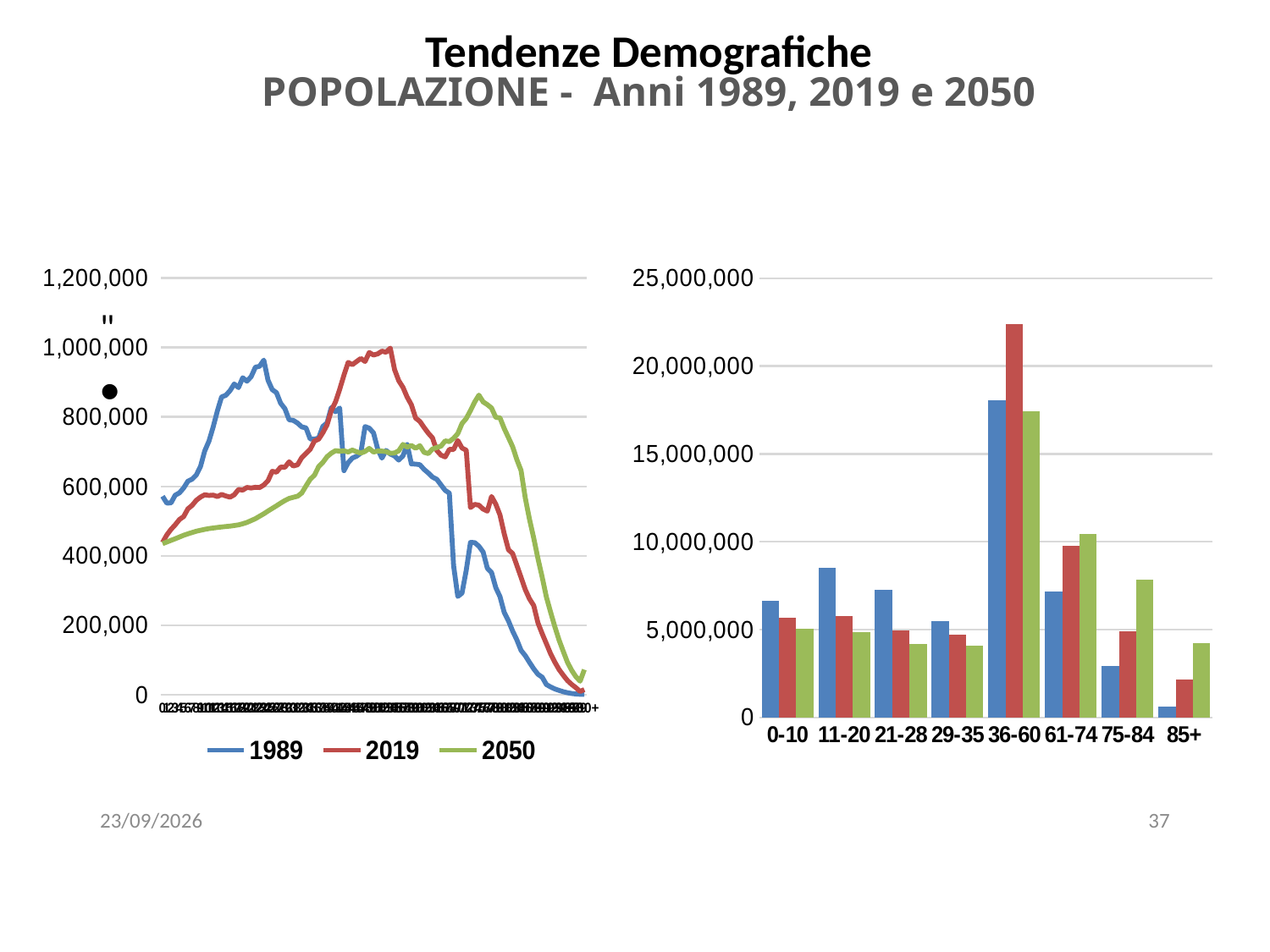
In the left chart, how many series does the legend list? 3 In the right chart, for the 75-84 age group, which is larger: the green bar or the blue bar? the green bar In the right chart, which age group has the tallest bars? 36-60 What kind of chart is the chart on the right of the slide? bar chart In the left chart, which years are listed in the legend? 1989, 2019, 2050 What kind of chart is the chart on the left of the slide? line chart In the right chart, for the 11-20 age group, which is larger: the blue bar or the red bar? the blue bar In the right chart, is the blue bar for 36-60 greater or less than 20,000,000? less In the right chart, how many age-group categories are shown on the x axis? 8 In the right chart, is the red bar for 36-60 greater or less than 20,000,000? greater In the left chart, is the peak of the 2050 line greater or less than 1,000,000? less